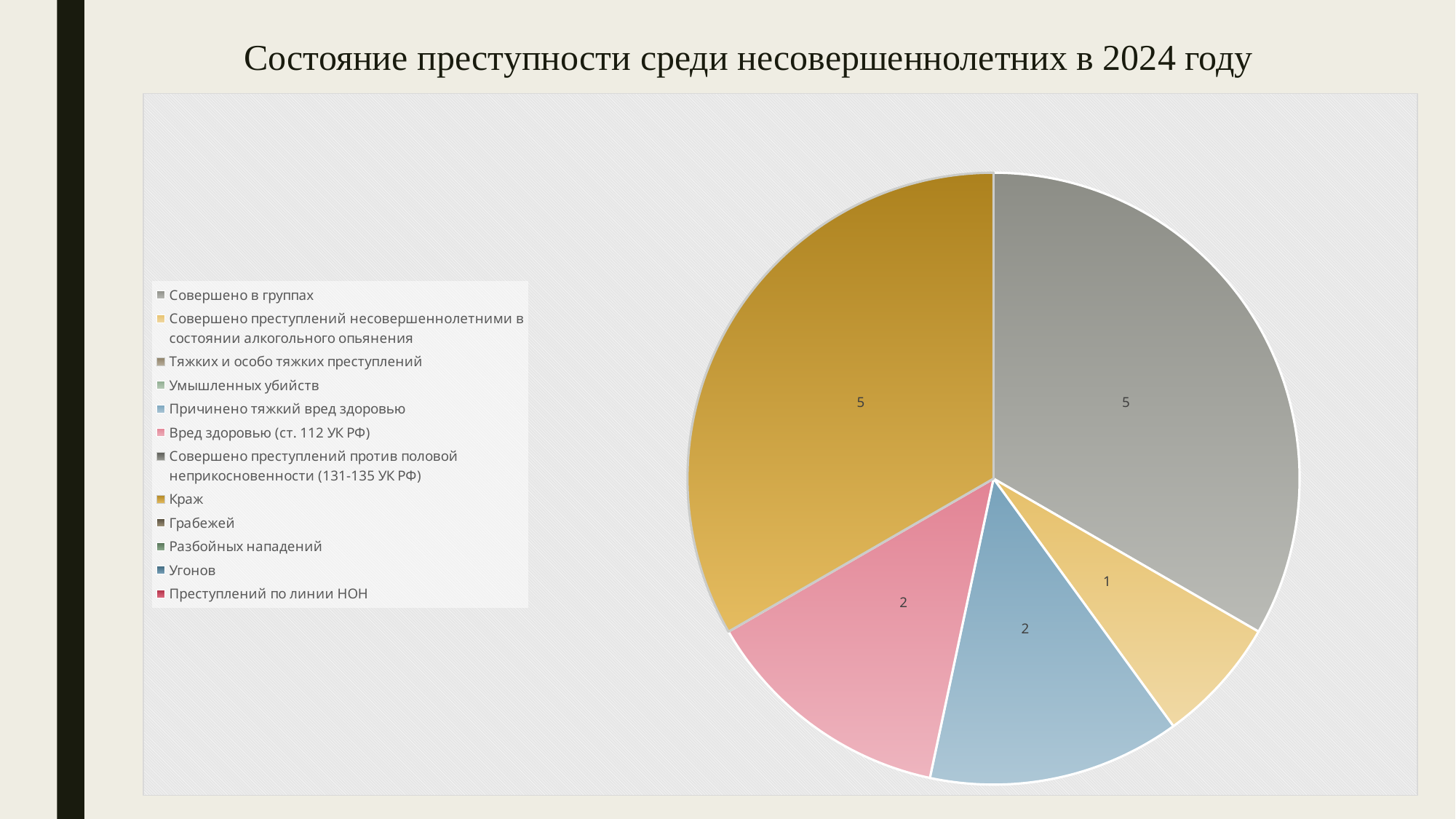
What is the value shown for the "Совершено в группах" slice? 5 What is the title of the slide? Состояние преступности среди несовершеннолетних в 2024 году Which labelled slice of the pie has the smallest value? Совершено преступлений несовершеннолетними в состоянии алкогольного опьянения Which is larger: the value for "Краж" or the value for "Вред здоровью (ст. 112 УК РФ)"? Краж How many entries does the legend list? 12 How many slices with data labels are visible in the pie? 5 What is the value shown for "Совершено преступлений несовершеннолетними в состоянии алкогольного опьянения"? 1 What is the difference between the value for "Краж" and the value for "Совершено преступлений несовершеннолетними в состоянии алкогольного опьянения"? 4 What is the value shown for the "Краж" slice? 5 What is the value shown for "Причинено тяжкий вред здоровью"? 2 What is the value shown for "Вред здоровью (ст. 112 УК РФ)"? 2 What kind of chart is shown on the slide? pie chart